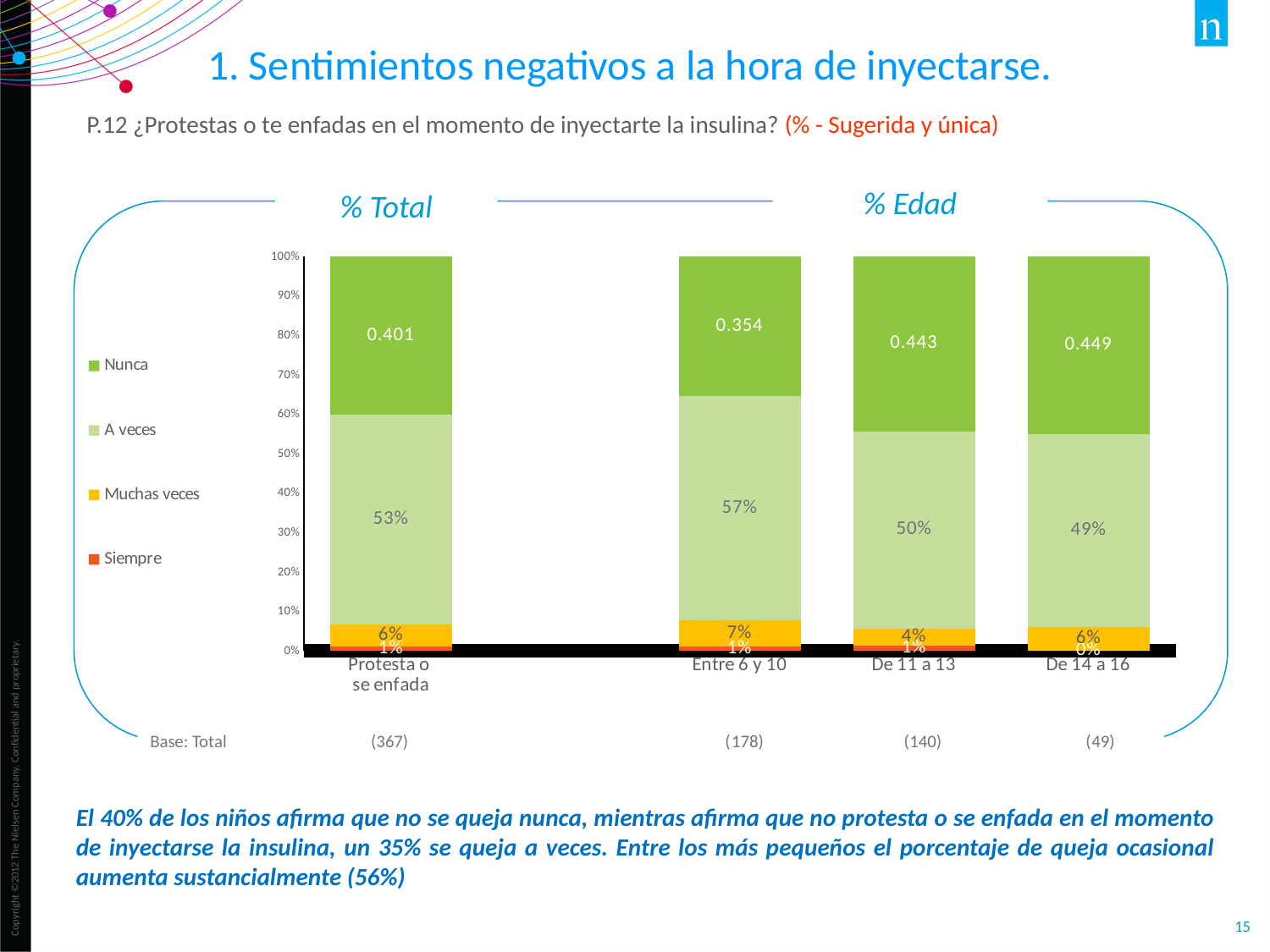
What is the value of the 'Siempre' segment for 'De 14 a 16'? 0% What is the difference between the 'A veces' values for 'Entre 6 y 10' and 'De 14 a 16'? 8% What is the value of the 'A veces' segment for 'De 11 a 13'? 50% How many series does the legend list? 4 Which category has the highest 'A veces' value? Entre 6 y 10 Which is larger: the 'Muchas veces' value for 'Entre 6 y 10' or for 'De 11 a 13'? Entre 6 y 10 Which category has the lowest 'Nunca' value? Entre 6 y 10 What kind of chart is shown on the slide? stacked bar chart What is the value of the 'Muchas veces' segment for 'Entre 6 y 10'? 7% What is the value of the 'Nunca' segment for 'Entre 6 y 10'? 0.354 How many bars are plotted in the chart? 4 Which legend entry is shown in orange? Siempre